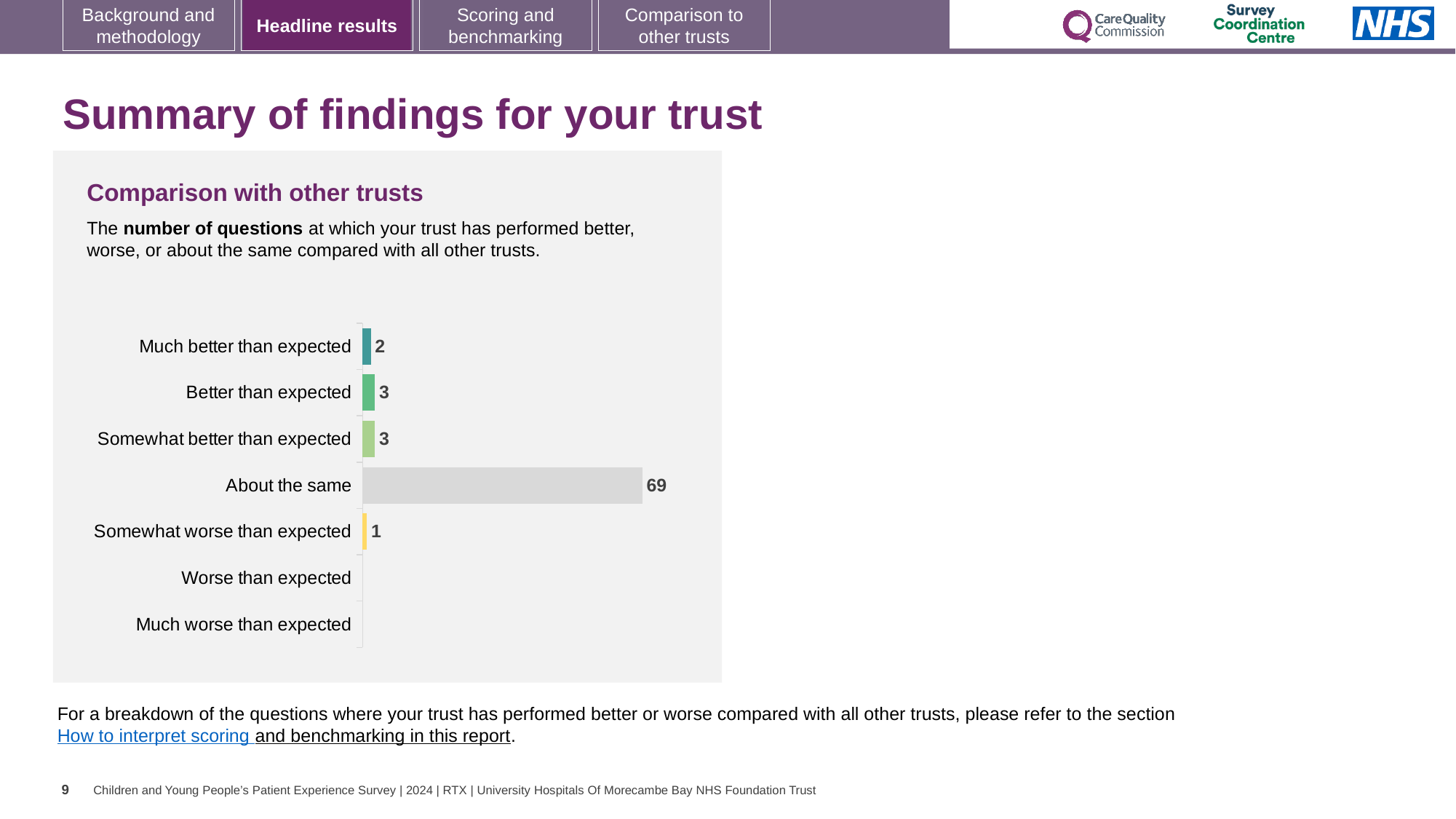
What is the total of the values shown for 'Much better than expected', 'Better than expected' and 'Somewhat better than expected'? 8 What kind of chart is shown on the slide? Bar chart What is the value for 'Much better than expected'? 2 What is the difference between the 'About the same' value and the 'Somewhat better than expected' value? 66 What is the value for 'Somewhat worse than expected'? 1 What colour is the bar for 'About the same'? Grey Which category has the highest number of questions? About the same What is the title of the chart section on the slide? Comparison with other trusts Which is larger: the value for 'Better than expected' or the value for 'Much better than expected'? Better than expected How many questions are in the 'About the same' category? 69 What is the value for 'Better than expected'? 3 How many categories are listed on the chart's axis? 7